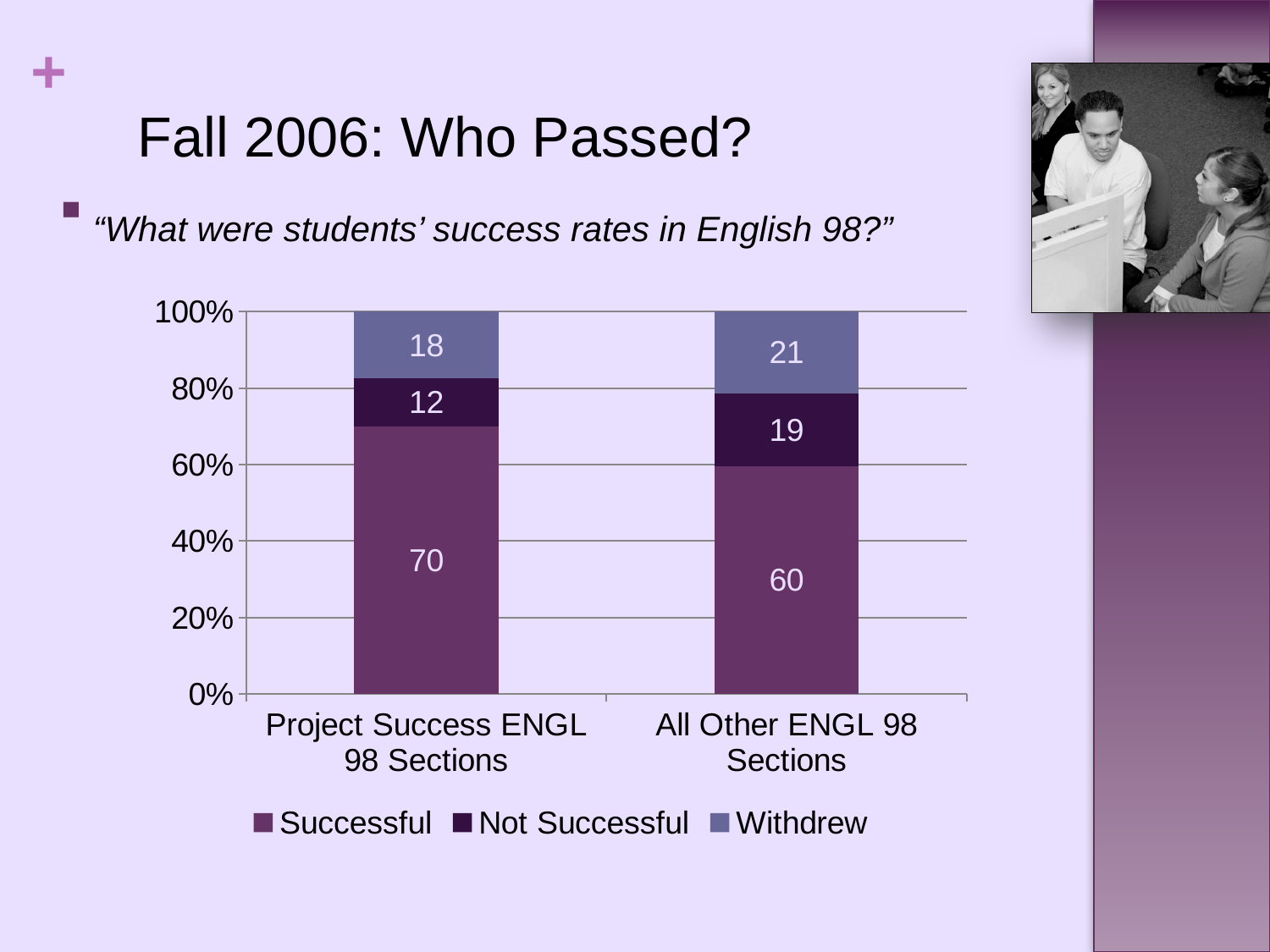
What is the difference between the Successful values for Project Success ENGL 98 Sections and All Other ENGL 98 Sections? 10 What kind of chart is shown on the slide? Stacked bar chart What is the Withdrew value for All Other ENGL 98 Sections? 21 How many series does the legend list? 3 What is the total of the three labelled values for All Other ENGL 98 Sections? 100 Is the Withdrew value larger for Project Success ENGL 98 Sections or All Other ENGL 98 Sections? All Other ENGL 98 Sections Which category has the lower Not Successful value? Project Success ENGL 98 Sections What is the Not Successful value for Project Success ENGL 98 Sections? 12 What is the Successful value for Project Success ENGL 98 Sections? 70 What is the Successful value for All Other ENGL 98 Sections? 60 Which category has the higher Successful value? Project Success ENGL 98 Sections How many categories are shown on the x axis? 2